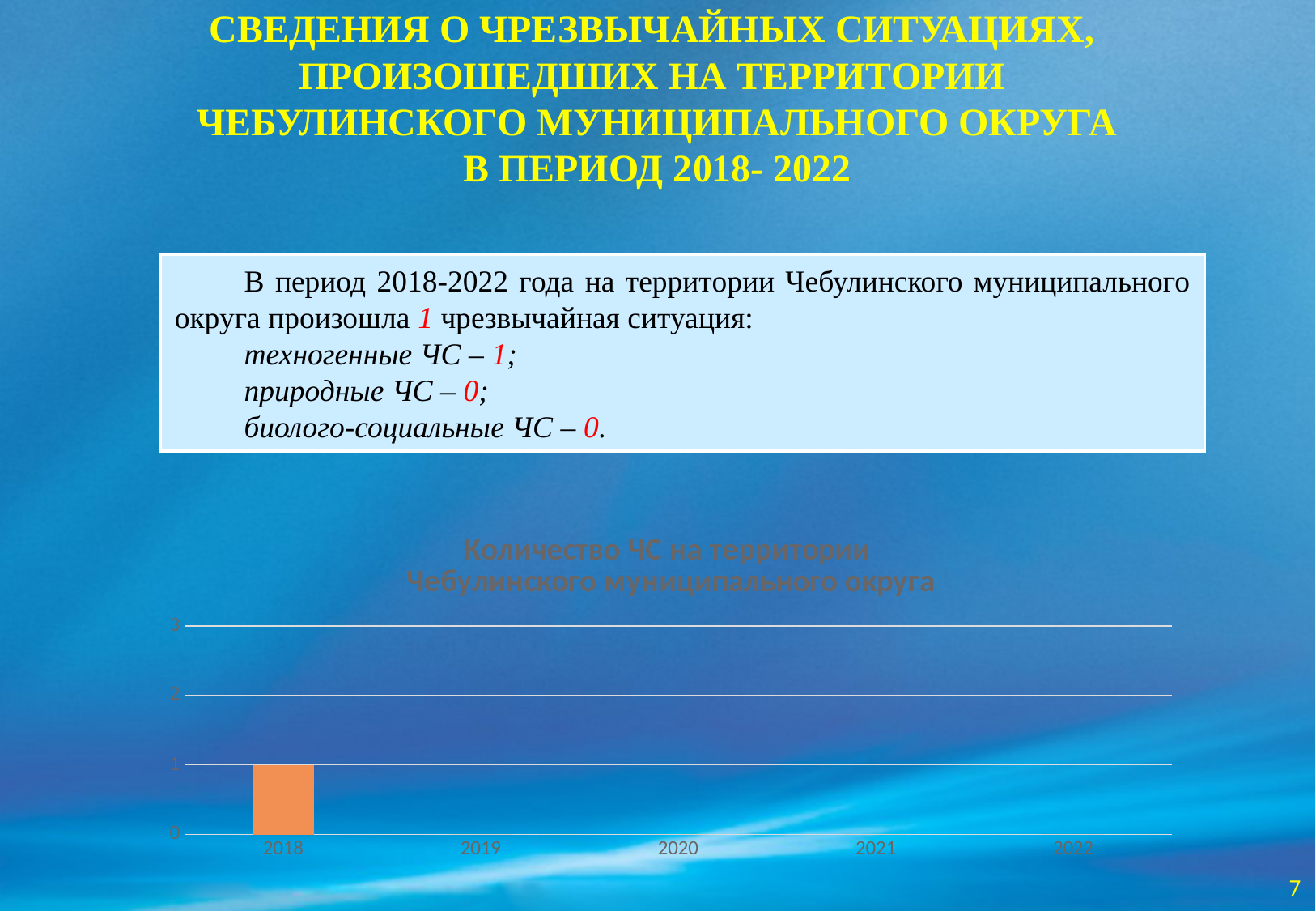
What is the difference between the values for 2018 and 2021? 1 Do the values rise or fall from 2018 to 2019? fall What is the value for 2022 in the chart? 0 How many years are shown on the x axis of the chart? 5 What is the value for 2018 in the chart? 1 Is the value for 2018 greater or less than 2? less Which year has the highest value in the chart? 2018 What is the highest tick value shown on the y axis of the chart? 3 What kind of chart is shown on the slide? bar chart What is the value for 2019 in the chart? 0 What is the title of the chart? Количество ЧС на территории Чебулинского муниципального округа Which is larger, the value for 2018 or the value for 2020? 2018